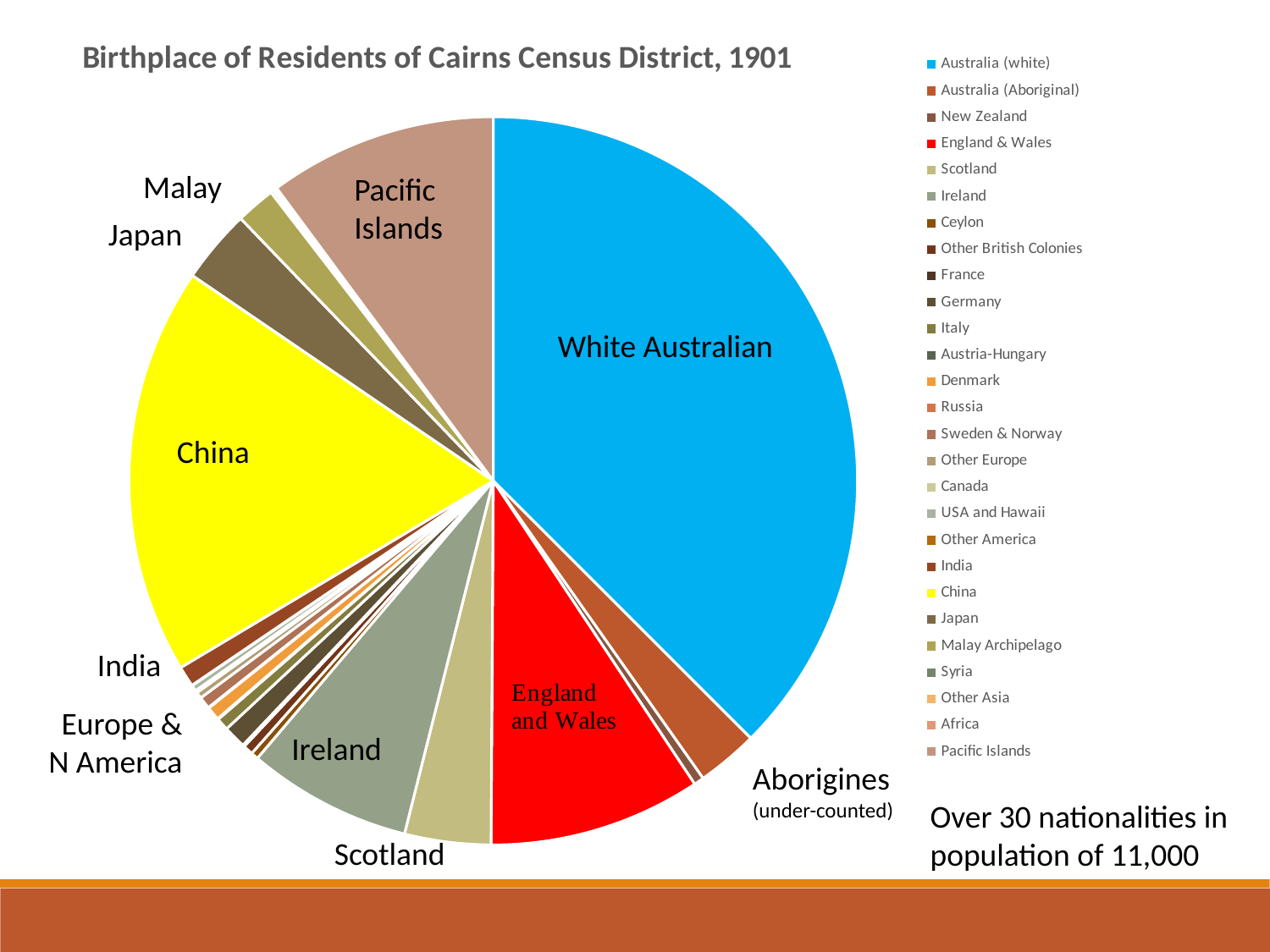
Which birthplace category has the largest slice of the pie? White Australian Which slice is larger, Pacific Islands or Japan? Pacific Islands How many entries does the legend list? 27 What colour is the China slice of the pie? yellow Which slice is larger, Ireland or Scotland? Ireland Which slice is larger, China or Ireland? China What is the title of the chart? Birthplace of Residents of Cairns Census District, 1901 What kind of chart is shown on the slide? pie chart